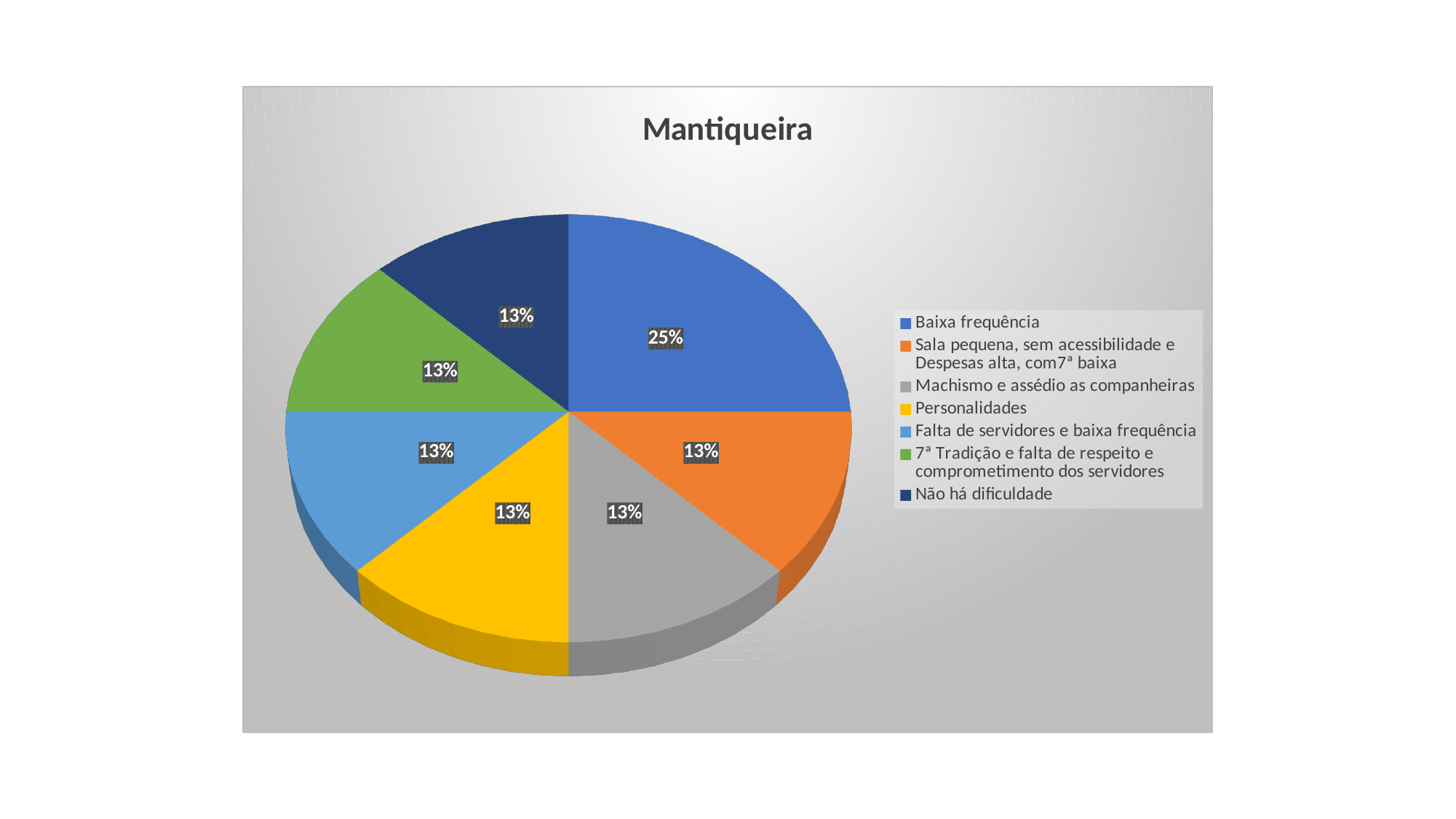
How many slices are labelled 13%? 6 What share of the pie does "Personalidades" have? 13% Which is larger, the slice for "Baixa frequência" or the slice for "Falta de servidores e baixa frequência"? Baixa frequência How many categories does the legend list? 7 What colour is the slice for "Personalidades"? yellow What share of the pie does "Baixa frequência" have? 25% What kind of chart is shown on the slide? pie chart What is the difference between the share for "Baixa frequência" and the share for "Personalidades"? 12% Which category has the largest slice of the pie? Baixa frequência What share of the pie does "Não há dificuldade" have? 13% What is the title of the chart? Mantiqueira